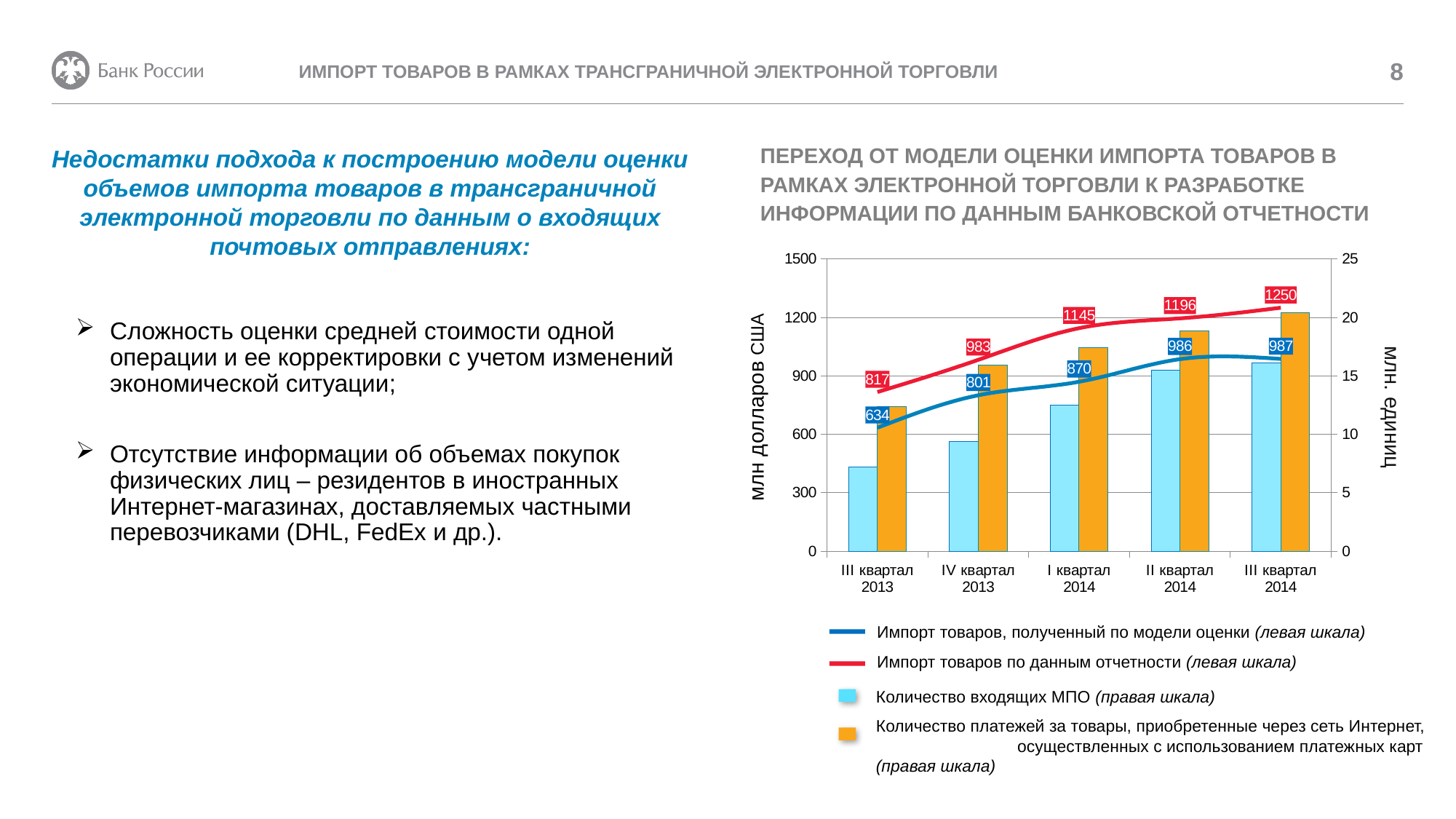
What is the value of the 'Импорт товаров по данным отчетности' line for III квартал 2014? 1250 How many quarters are shown on the x axis of the chart? 5 In IV квартал 2013, which is larger: the 'Импорт товаров по данным отчетности' value or the 'Импорт товаров, полученный по модели оценки' value? Импорт товаров по данным отчетности Is the 'Количество входящих МПО' bar for III квартал 2013 greater or less than 10 on the right scale? less What is the value of the 'Импорт товаров, полученный по модели оценки' line for I квартал 2014? 870 By how much did the 'Импорт товаров, полученный по модели оценки' value increase from III квартал 2013 to IV квартал 2013? 167 How many series does the chart legend list? 4 In which quarter is the 'Импорт товаров по данным отчетности' line at its highest? III квартал 2014 Does the 'Импорт товаров по данным отчетности' line rise or fall from III квартал 2013 to III квартал 2014? rise In III квартал 2014, what is the difference between the 'Импорт товаров по данным отчетности' value and the 'Импорт товаров, полученный по модели оценки' value? 263 What is the value of the 'Импорт товаров по данным отчетности' line for III квартал 2013? 817 In which quarter is the 'Импорт товаров по данным отчетности' line at its lowest? III квартал 2013